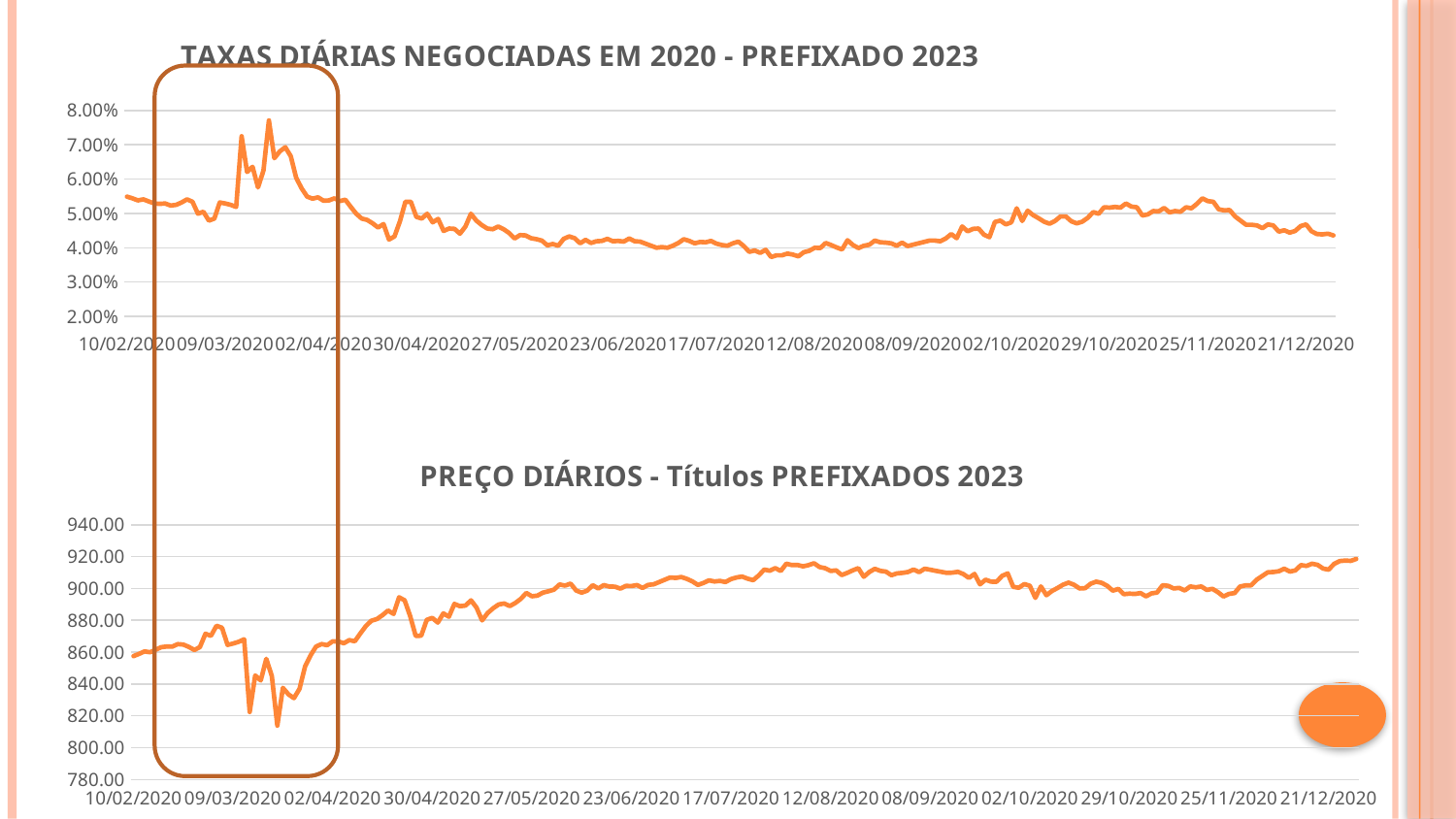
In the top chart (TAXAS DIÁRIAS NEGOCIADAS EM 2020 - PREFIXADO 2023), is the value at 21/12/2020 greater or less than 5.00%? less In the top chart (TAXAS DIÁRIAS NEGOCIADAS EM 2020 - PREFIXADO 2023), is the value at 10/02/2020 greater or less than 5.00%? greater In the top chart (TAXAS DIÁRIAS NEGOCIADAS EM 2020 - PREFIXADO 2023), is the lowest value of the line greater or less than 4.00%? less What is the title of the bottom chart on the slide? PREÇO DIÁRIOS - Títulos PREFIXADOS 2023 In the bottom chart (PREÇO DIÁRIOS - Títulos PREFIXADOS 2023), does the line overall rise or fall from 10/02/2020 to 21/12/2020? rise What kind of chart is the top chart titled "TAXAS DIÁRIAS NEGOCIADAS EM 2020 - PREFIXADO 2023"? line chart How many date labels are shown on the x axis of the bottom chart (PREÇO DIÁRIOS - Títulos PREFIXADOS 2023)? 13 In the bottom chart (PREÇO DIÁRIOS - Títulos PREFIXADOS 2023), which is larger: the value at 10/02/2020 or the value at 21/12/2020? 21/12/2020 In the top chart (TAXAS DIÁRIAS NEGOCIADAS EM 2020 - PREFIXADO 2023), which is larger: the value at 09/03/2020 or the value at 21/12/2020? 09/03/2020